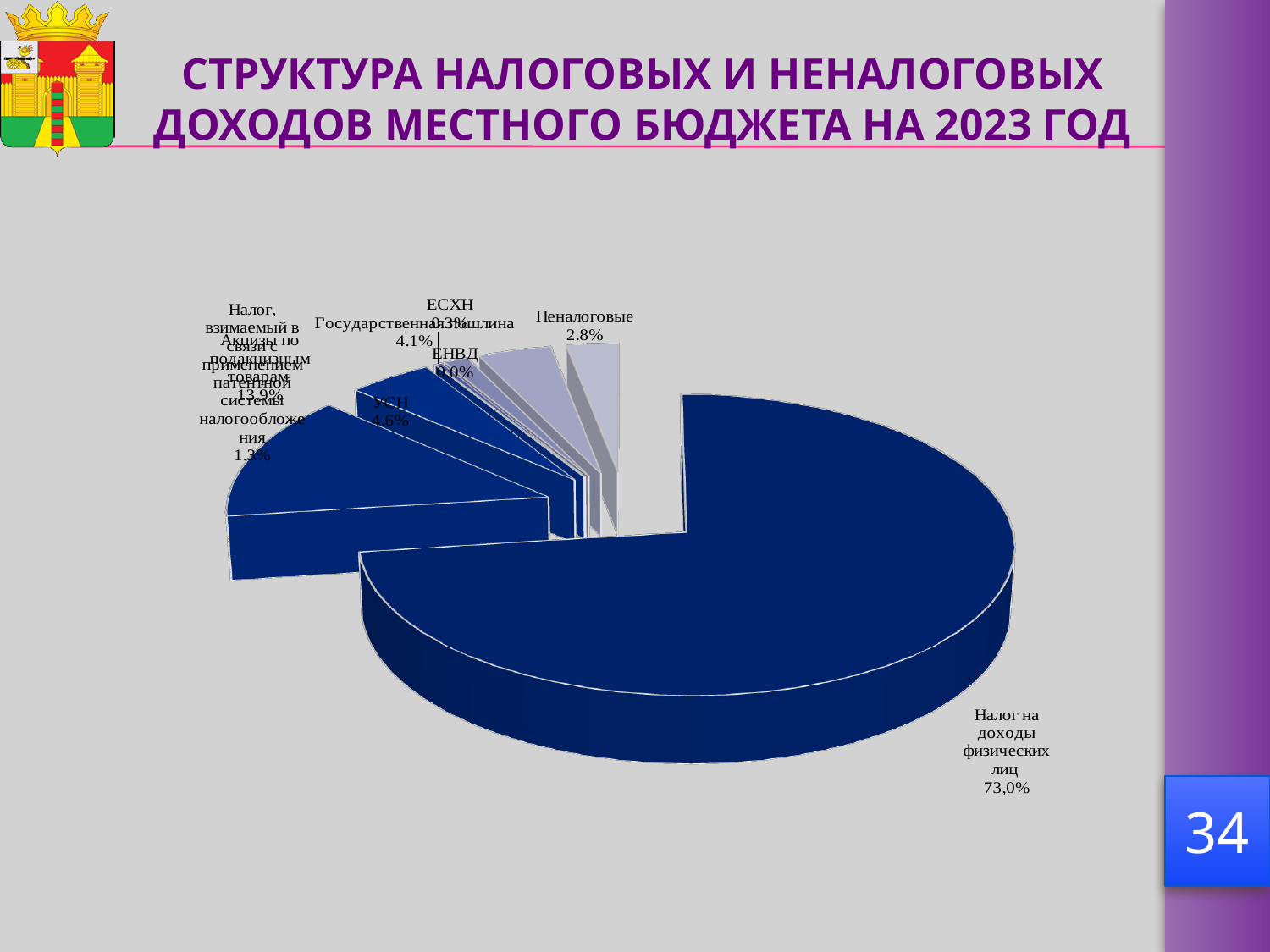
How many slices does the pie chart have? 8 What share is shown for Акцизы по подакцизным товарам? 13.9% What is the difference in percentage points between Налог на доходы физических лиц and Неналоговые? 70,2 What share is shown for УСН? 4.6% What share is shown for Неналоговые? 2.8% What share of the pie is labelled for Налог на доходы физических лиц? 73,0% What kind of chart is shown on the slide? pie chart What share is shown for Государственная пошлина? 4.1% Which is larger, the share for УСН or the share for Государственная пошлина? УСН Which category has the smallest share of the pie? ЕНВД Which category has the largest share of the pie? Налог на доходы физических лиц What share is shown for ЕНВД? 0.0%